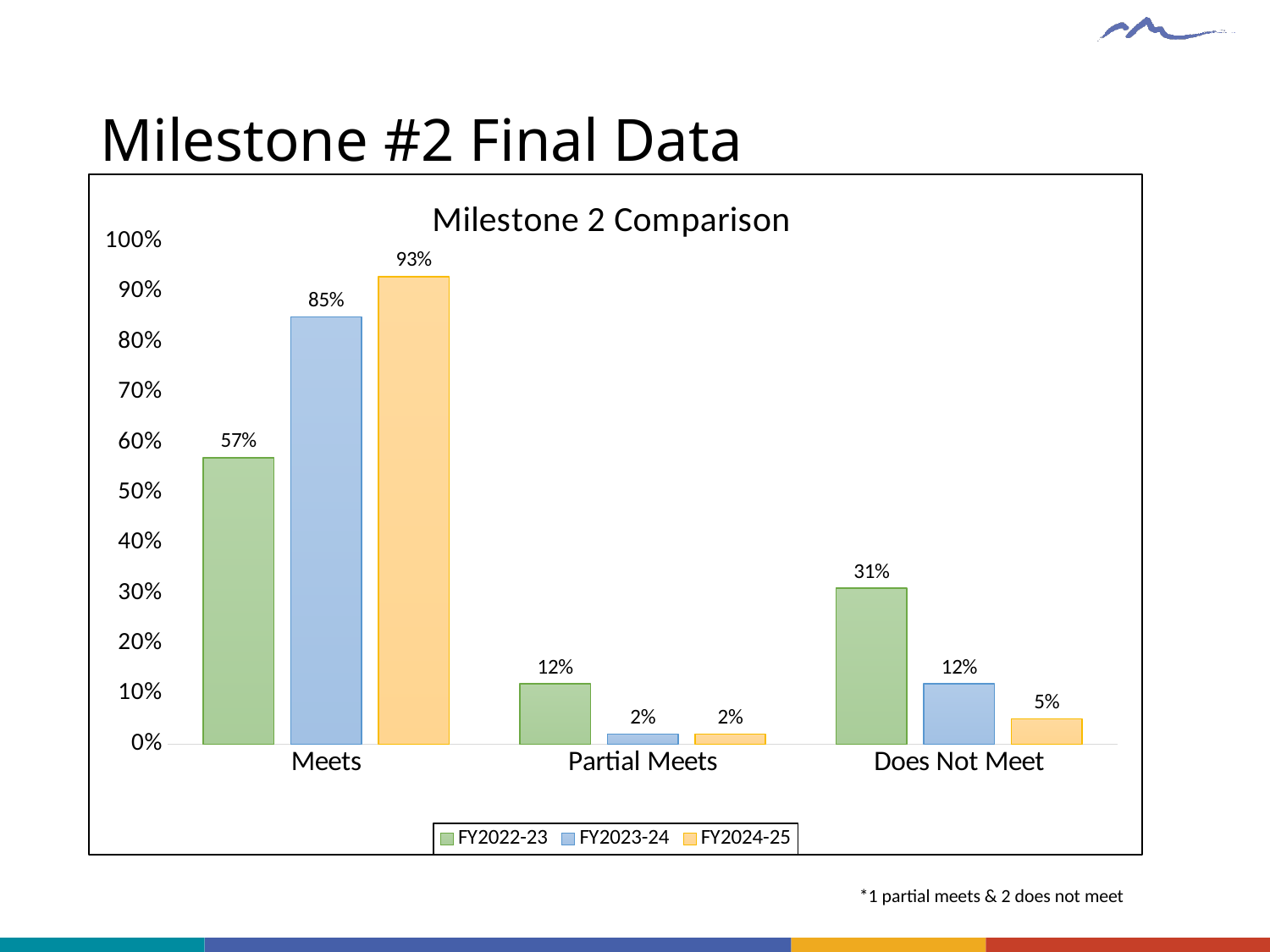
What kind of chart is shown? Bar chart What is the value for FY2024-25 in the Meets category? 93% What is the value for FY2023-24 in the Partial Meets category? 2% How many categories are shown on the x axis? 3 What is the value for FY2022-23 in the Does Not Meet category? 31% How many series does the legend list? 3 Which series has the highest value in the Meets category? FY2024-25 What is the difference between the FY2024-25 and FY2022-23 values in the Meets category? 36% What is the difference between the FY2022-23 and FY2023-24 values in the Does Not Meet category? 19% Which is larger: the FY2022-23 value for Partial Meets or the FY2024-25 value for Does Not Meet? FY2022-23 value for Partial Meets Which series has the lowest value in the Does Not Meet category? FY2024-25 What is the title of the chart? Milestone 2 Comparison